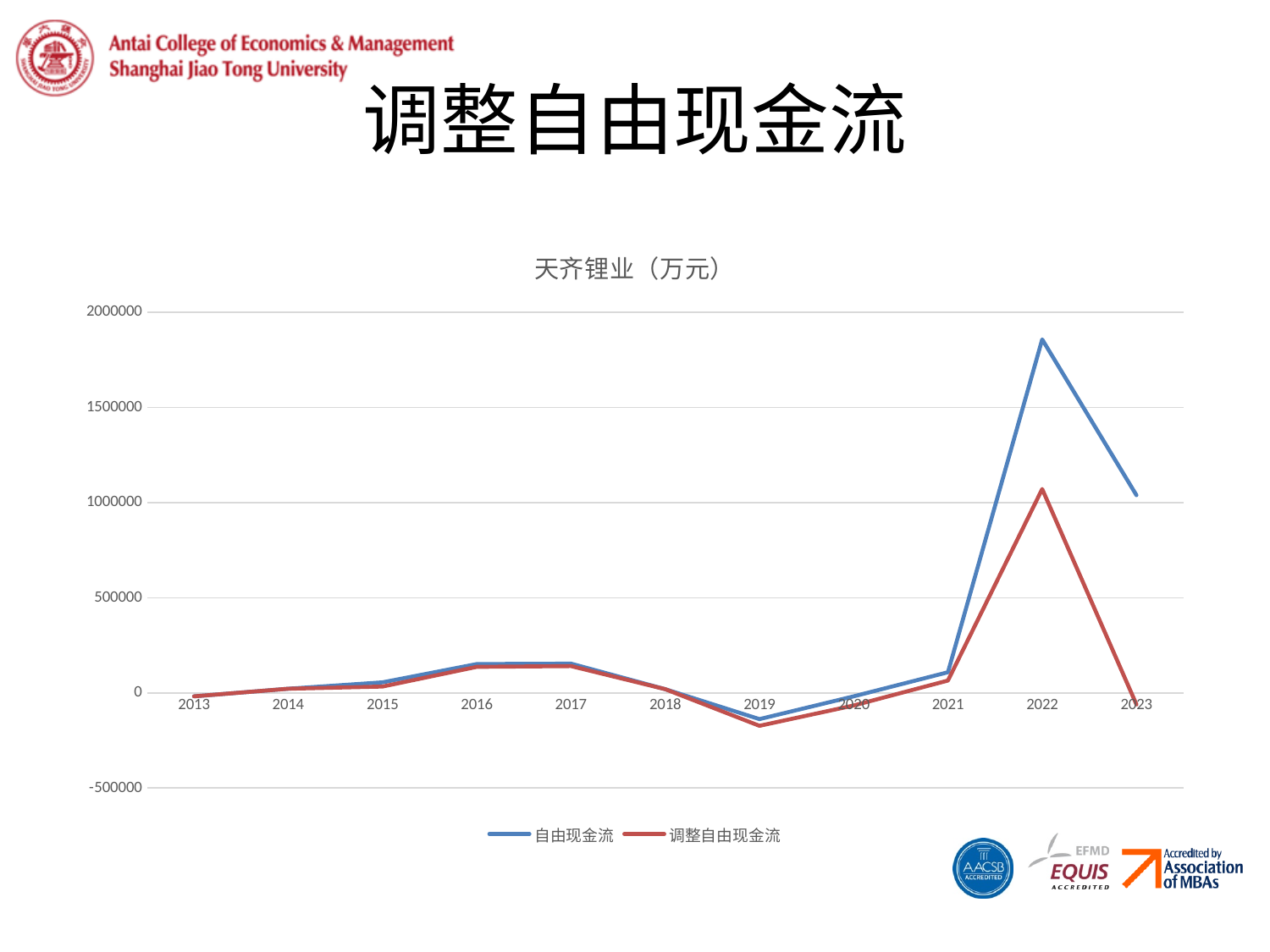
In which year does 调整自由现金流 reach its highest value? 2022 What is the title of the chart? 天齐锂业（万元） How many years are shown on the x axis? 11 Do both series rise or fall from 2022 to 2023? fall Is the value of 调整自由现金流 in 2023 greater or less than 500000? less Is the value of 调整自由现金流 in 2022 greater or less than 1000000? greater How many series does the legend list? 2 In 2022, which series has the larger value, 自由现金流 or 调整自由现金流? 自由现金流 Is the value of 自由现金流 in 2022 greater or less than 1500000? greater What kind of chart is shown on the slide? line chart In which year does 自由现金流 reach its highest value? 2022 In which year is 调整自由现金流 at its lowest? 2019